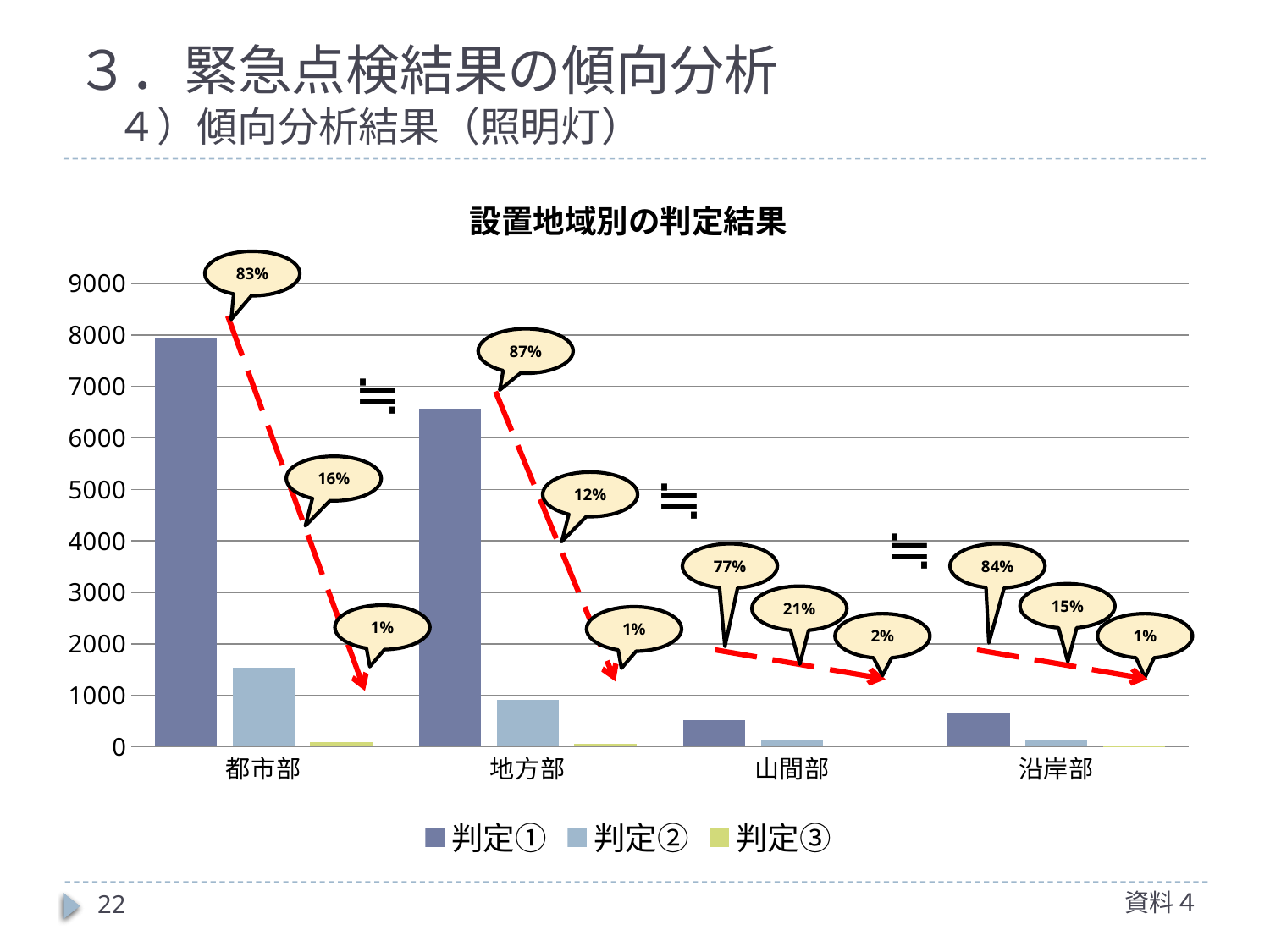
Is the value for 判定① in 都市部 greater or less than 7000? greater What kind of chart is shown on the slide? bar chart Which category has the highest value for 判定①? 都市部 What is the title of the chart? 設置地域別の判定結果 Is the value for 判定② in 都市部 greater or less than 1000? greater How many series does the legend list? 3 How many categories are shown on the x axis? 4 Which category has the lowest value for 判定①? 山間部 Which is larger, 判定① in 都市部 or 判定① in 地方部? 判定① in 都市部 Is the value for 判定① in 地方部 greater or less than 7000? less Does the value for 判定① rise or fall from 都市部 to 地方部 to 山間部? fall What percentage is shown in the callout for 判定① in 地方部? 87%